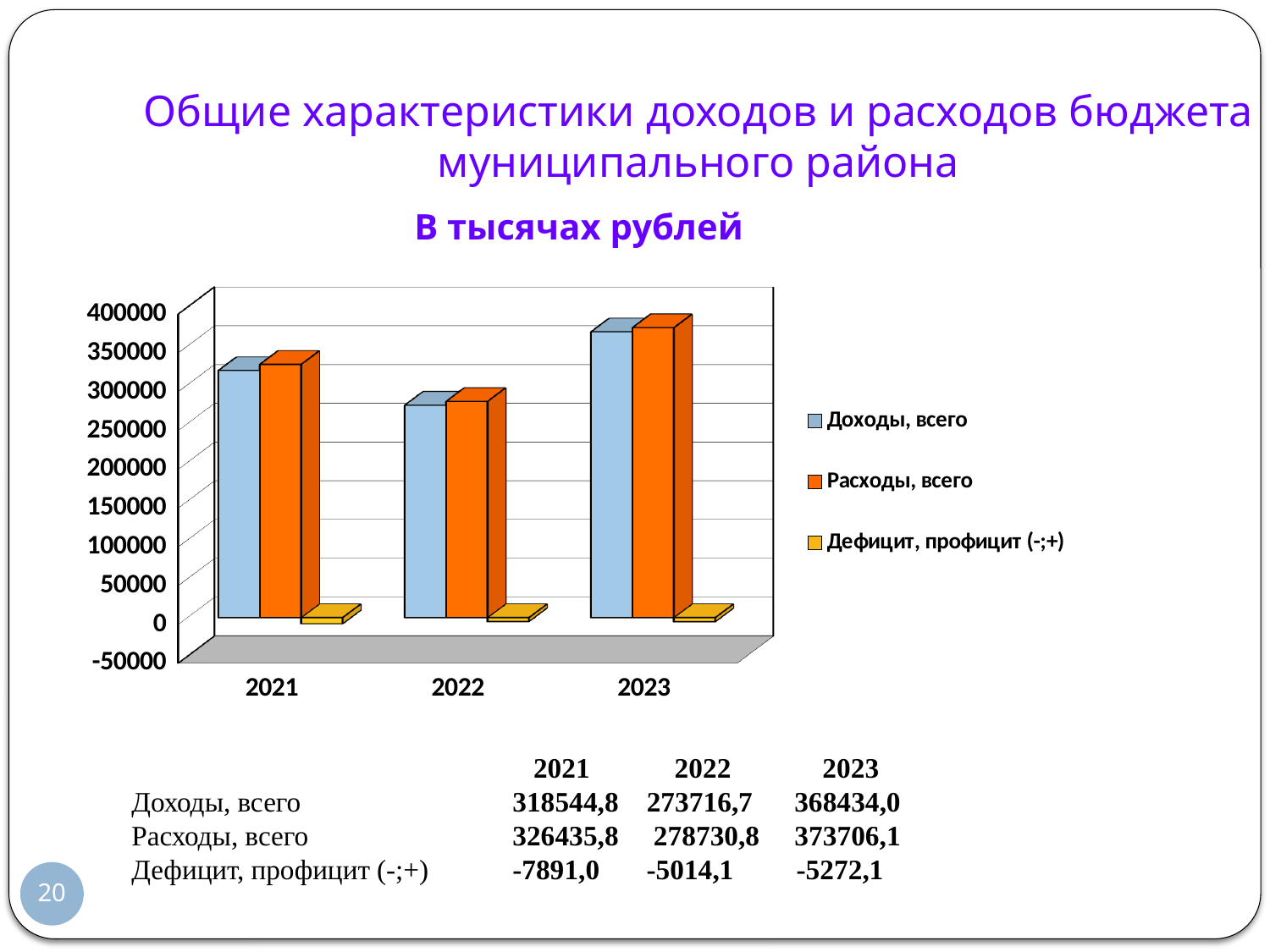
What is the value of Расходы, всего for 2023? 373706,1 How many series does the chart legend list? 3 What kind of chart is shown on the slide? bar chart What is the value of Доходы, всего for 2021? 318544,8 What is the value of Дефицит, профицит (-;+) for 2022? -5014,1 How many years are shown on the x axis of the chart? 3 What unit is stated in the chart's subtitle? В тысячах рублей In which year is Расходы, всего the lowest? 2022 What is the difference between Расходы, всего and Доходы, всего in 2023? 5272,1 Which is larger in 2021: Доходы, всего or Расходы, всего? Расходы, всего Is the value of Доходы, всего for 2022 greater or less than 300000? less In which year is Доходы, всего the highest? 2023